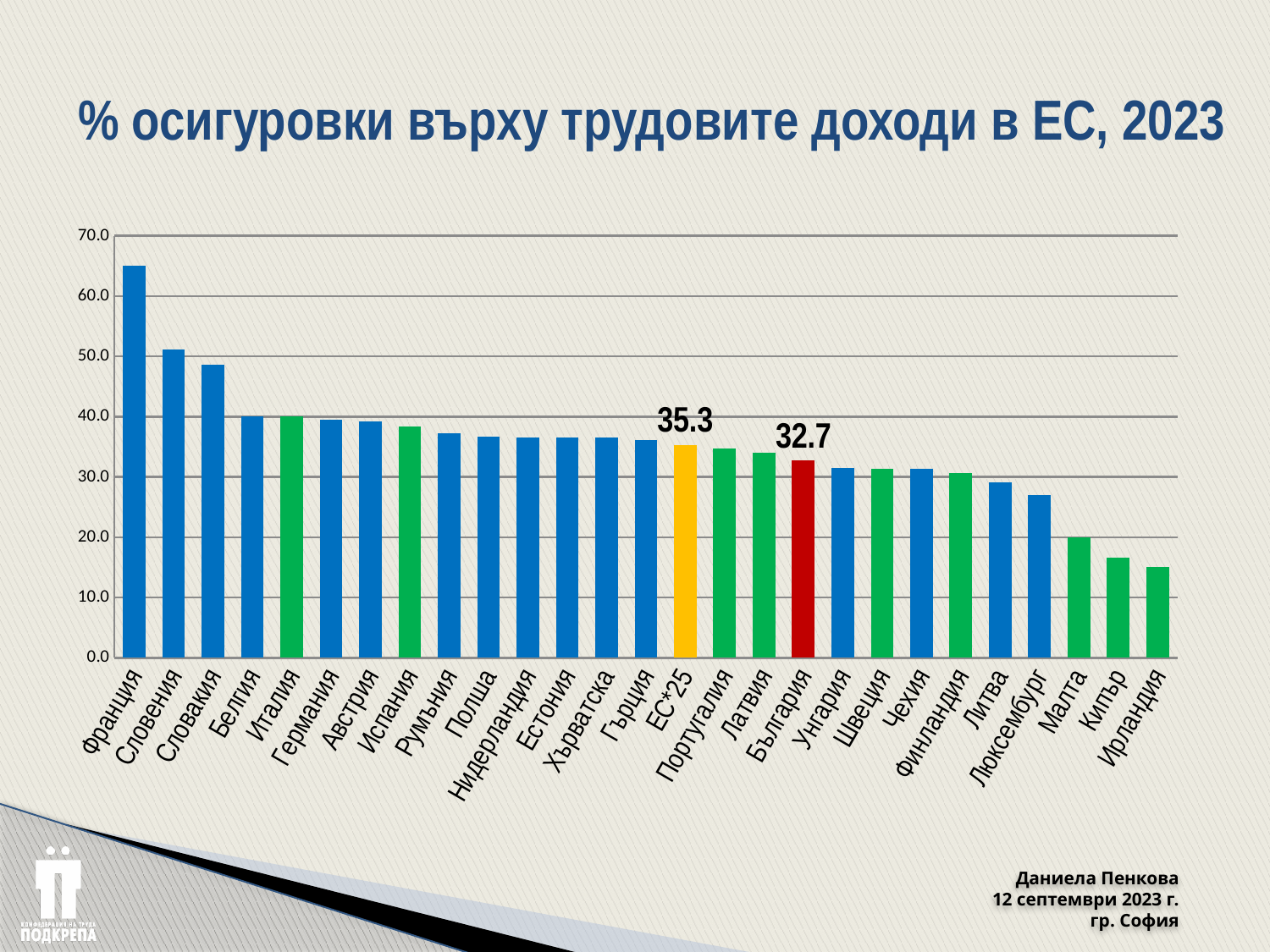
Do the values rise or fall from left to right along the x axis? fall What type of chart is shown on the slide? bar chart What is the value for ЕС*25? 35.3 Is the value for Кипър greater or less than 20? less How many bars are plotted in the chart? 27 Which is larger, the value for ЕС*25 or the value for България? ЕС*25 Which country has the lowest value? Ирландия Is the value for Люксембург greater or less than 30? less Which country has the highest value? Франция What is the difference between the values for ЕС*25 and България? 2.6 What is the value for България? 32.7 Is the value for Франция greater or less than 60? greater